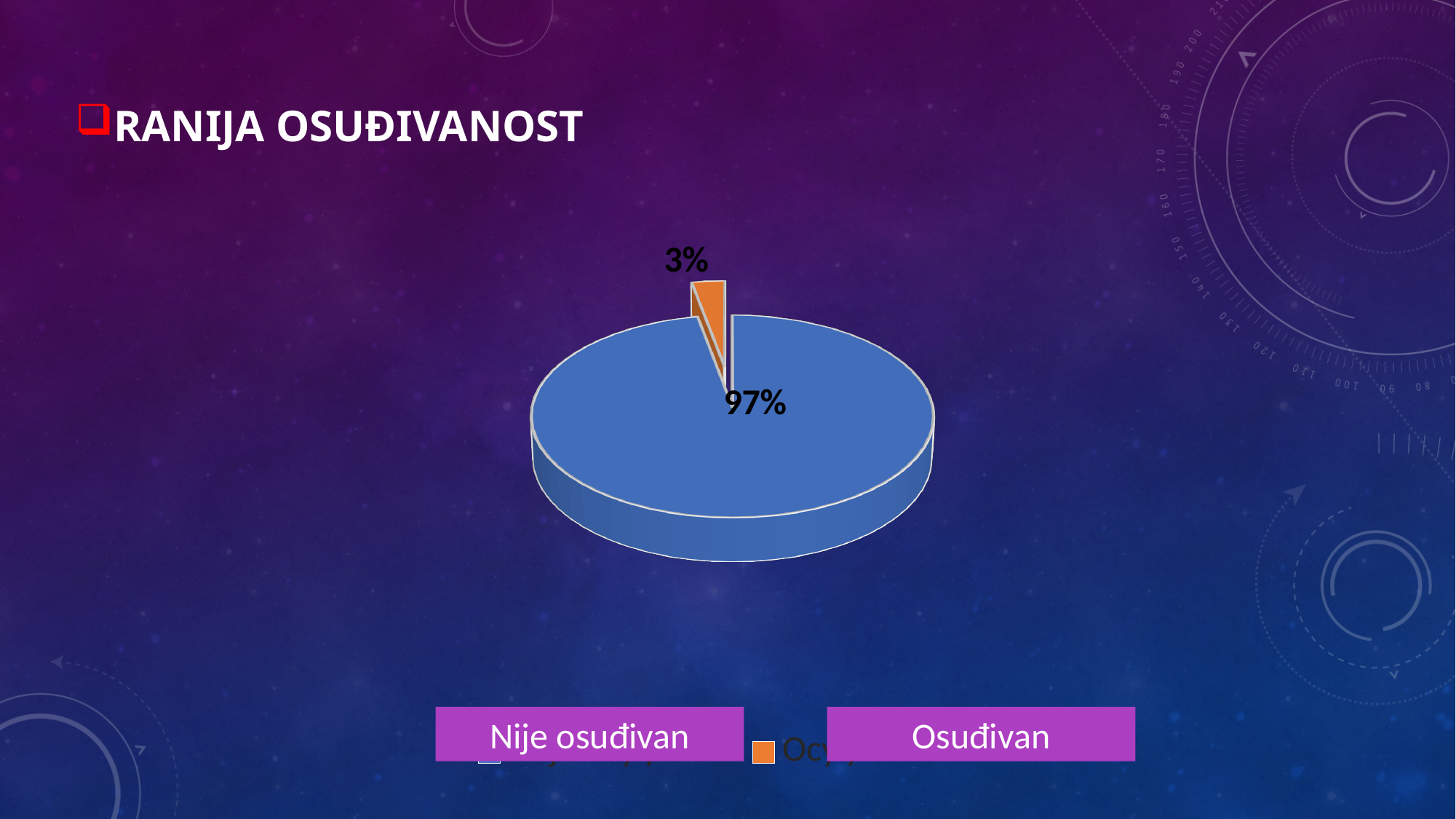
What kind of chart is shown on the slide? pie chart What share of the pie does the "Osuđivan" slice represent? 3% What share of the pie does the "Nije osuđivan" slice represent? 97% What is the value shown on the orange slice of the pie? 3% Which category has the smallest slice of the pie? Osuđivan Which is larger, the "Osuđivan" slice or the "Nije osuđivan" slice? Nije osuđivan What is the value shown on the blue slice of the pie? 97% Which category has the largest slice of the pie? Nije osuđivan How many slices does the pie chart have? 2 What is the difference in percentage points between the "Nije osuđivan" and "Osuđivan" slices? 94 What is the title of the slide above the pie chart? RANIJA OSUĐIVANOST What colour is the "Osuđivan" slice of the pie? orange